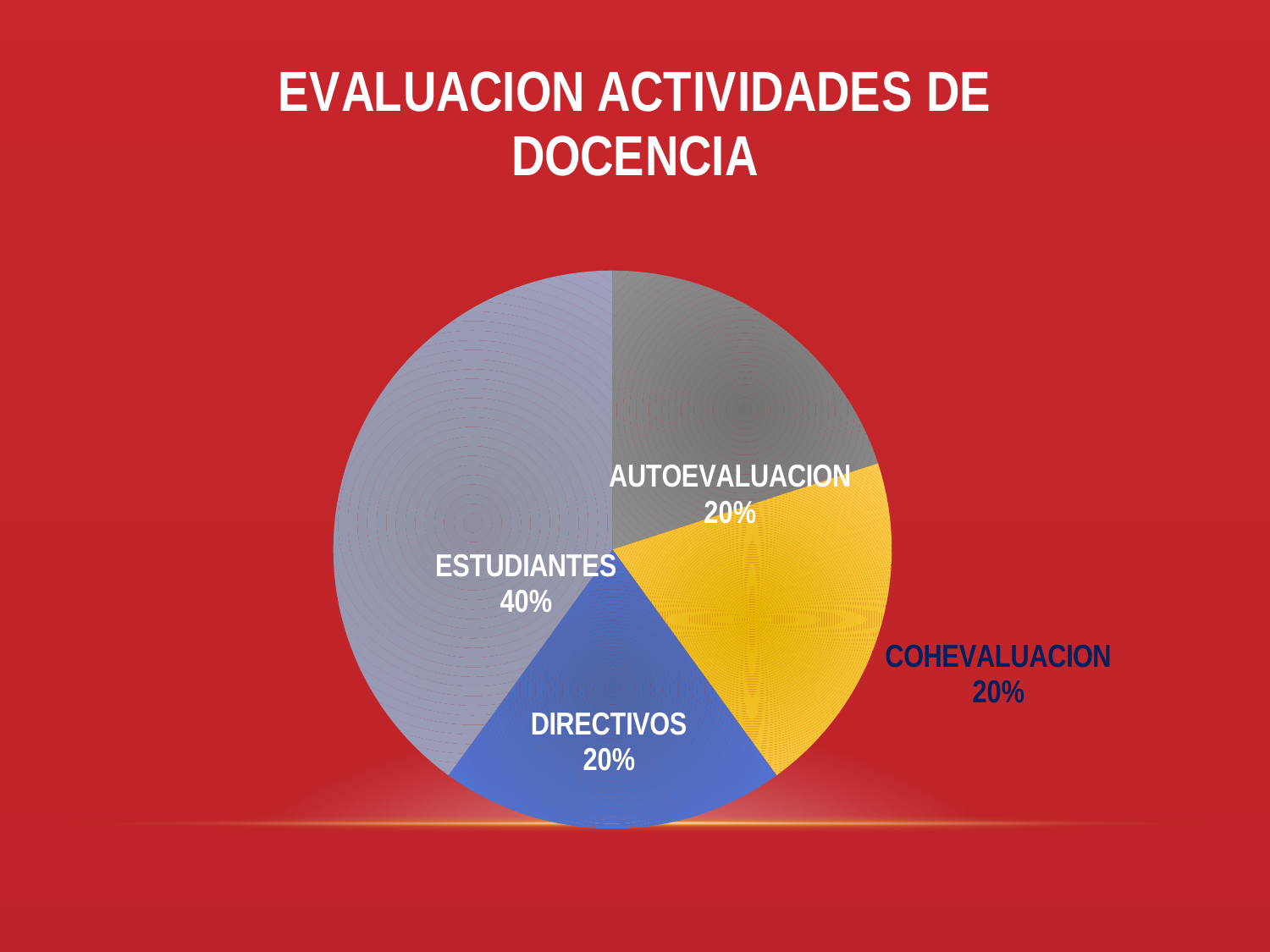
Which category has the largest slice of the pie? ESTUDIANTES What share of the pie does COHEVALUACION have? 20% What kind of chart is shown on the slide? pie chart What share of the pie does ESTUDIANTES have? 40% What is the combined share of AUTOEVALUACION and COHEVALUACION? 40% Which is larger, the ESTUDIANTES slice or the AUTOEVALUACION slice? ESTUDIANTES How many slices does the pie chart have? 4 What share of the pie does DIRECTIVOS have? 20% What is the difference between the ESTUDIANTES share and the DIRECTIVOS share? 20% What is the title of the chart? EVALUACION ACTIVIDADES DE DOCENCIA What colour is the DIRECTIVOS slice? blue